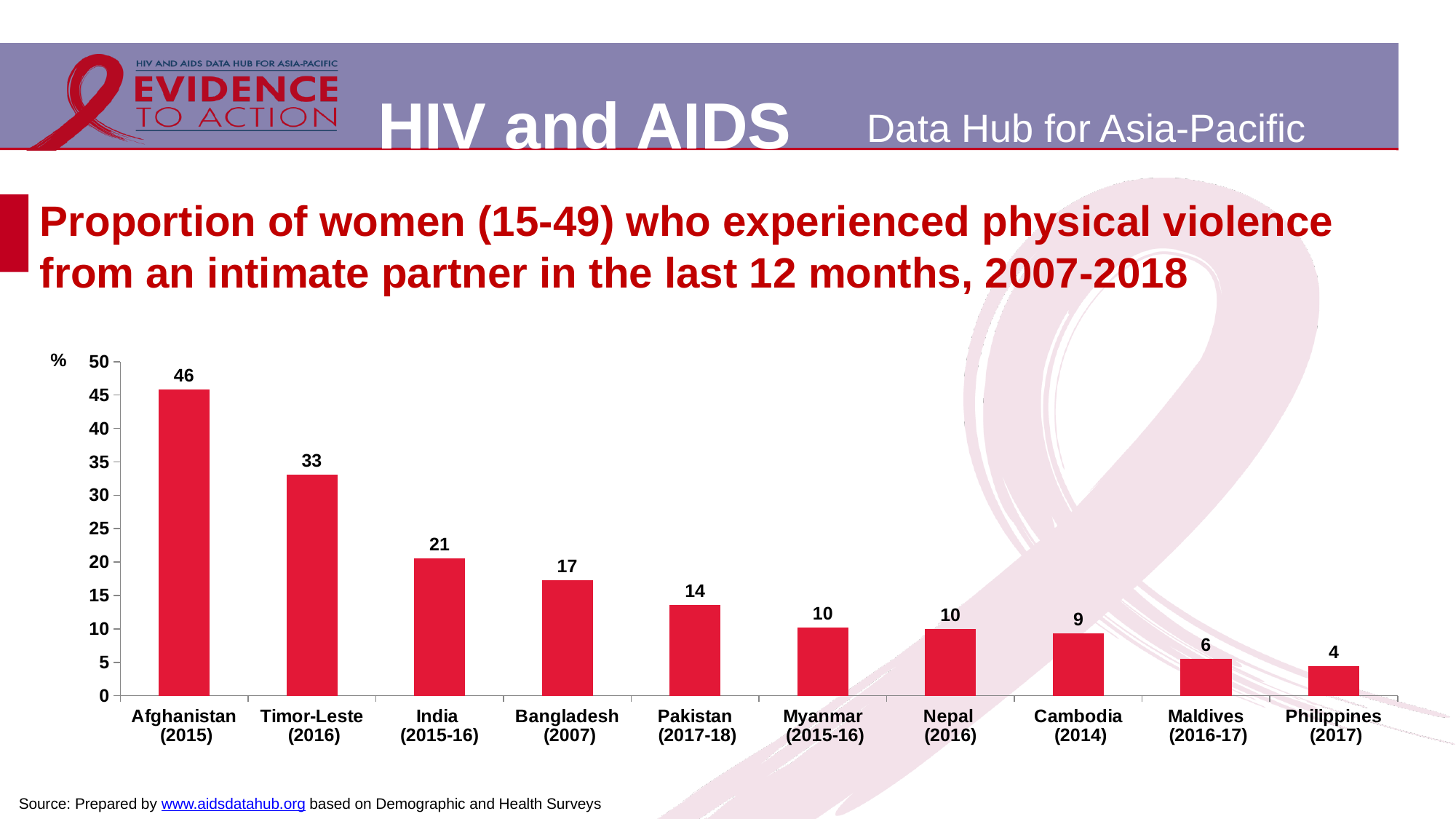
What is the value for Afghanistan (2015)? 46 Which country has the lowest value? Philippines (2017) How many countries are shown on the chart? 10 What is the value for Bangladesh (2007)? 17 What is the difference between the values for Afghanistan (2015) and Timor-Leste (2016)? 13 Which is larger, the value for India (2015-16) or the value for Pakistan (2017-18)? India (2015-16) Do the values rise or fall from left to right along the x axis? fall What kind of chart is shown on the slide? bar chart What unit is shown on the y axis of the chart? % Is the value for Timor-Leste (2016) greater or less than 30? greater What is the value for Cambodia (2014)? 9 Which country has the highest value? Afghanistan (2015)